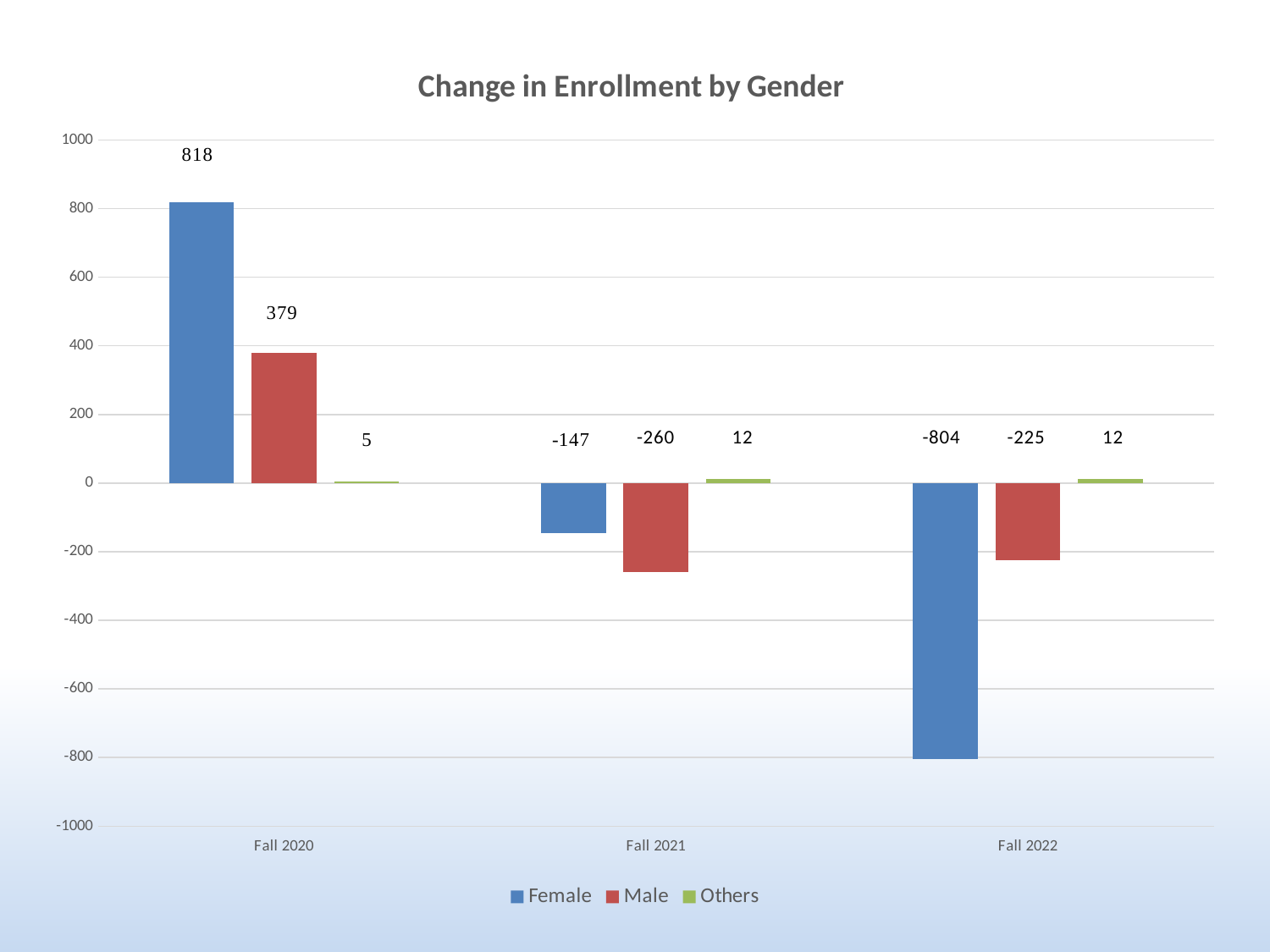
How many terms are shown on the x axis? 3 What kind of chart is this? Bar chart Which term has the lowest value for Male? Fall 2021 Which is larger, the Male value in Fall 2021 or the Male value in Fall 2022? Fall 2022 What is the value for Female in Fall 2022? -804 What is the value for Male in Fall 2021? -260 How many series does the legend list? 3 What is the difference between the Female and Male values in Fall 2020? 439 Which term has the highest value for Female? Fall 2020 What is the value for Others in Fall 2022? 12 What is the title of the chart? Change in Enrollment by Gender What is the value for Female in Fall 2020? 818